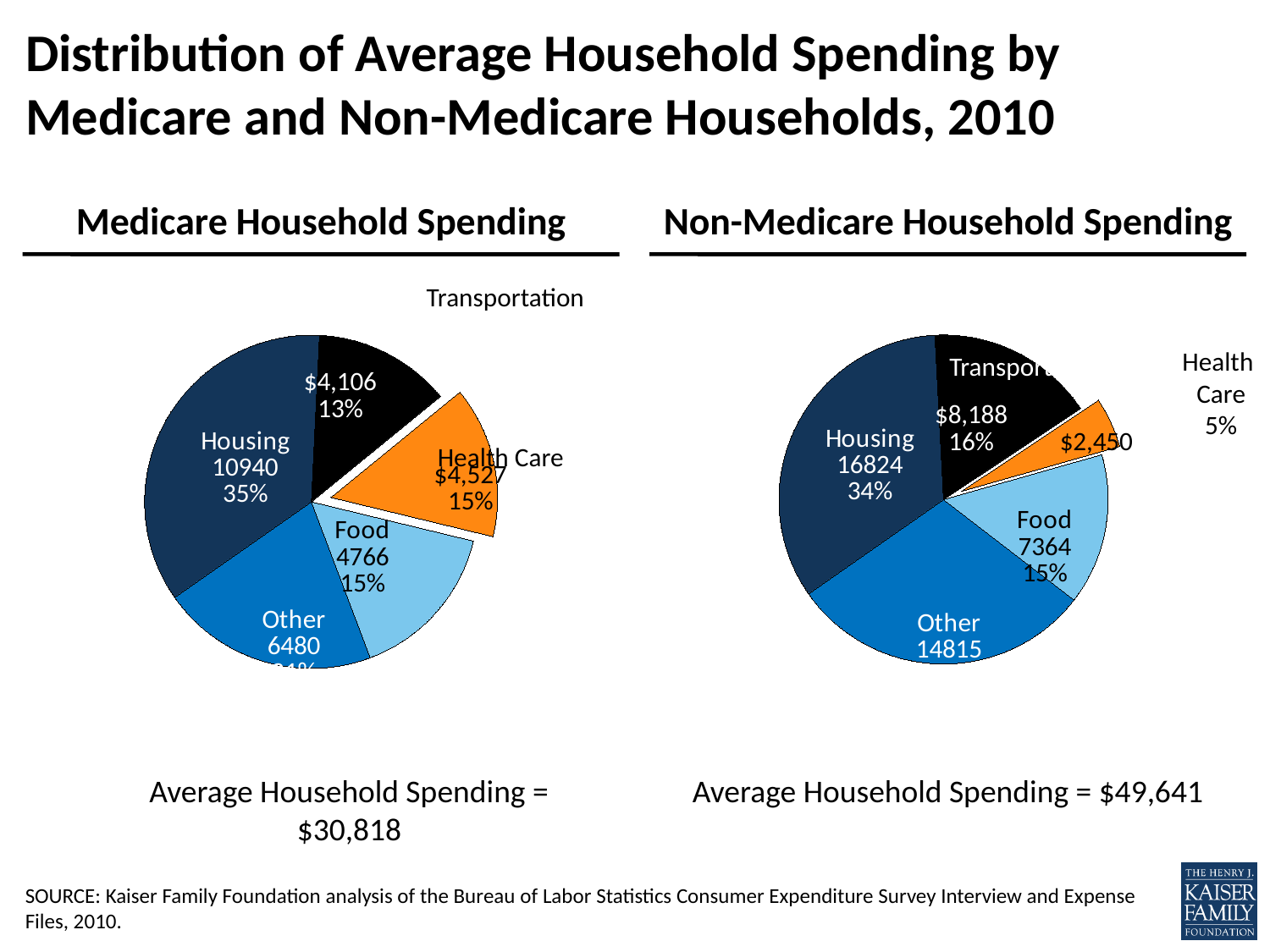
In the Medicare Household Spending chart, what share of spending is Health Care? 15% In the Non-Medicare Household Spending chart, what is the value for Health Care? $2,450 In the Medicare Household Spending chart, what is the value for Transportation? $4,106 What kind of chart is used for Medicare Household Spending? Pie chart In the Non-Medicare Household Spending chart, which category is the smallest? Health Care In the Medicare Household Spending chart, what is the value for Housing? 10940 How many categories does the Non-Medicare Household Spending chart show? 5 In the Medicare Household Spending chart, which is larger, Other or Food? Other In the Non-Medicare Household Spending chart, which category is the largest? Housing What is the average household spending shown under the Medicare Household Spending chart? $30,818 In the Non-Medicare Household Spending chart, what share of spending is Transportation? 16% In the Non-Medicare Household Spending chart, what is the difference between Housing and Other? 2009